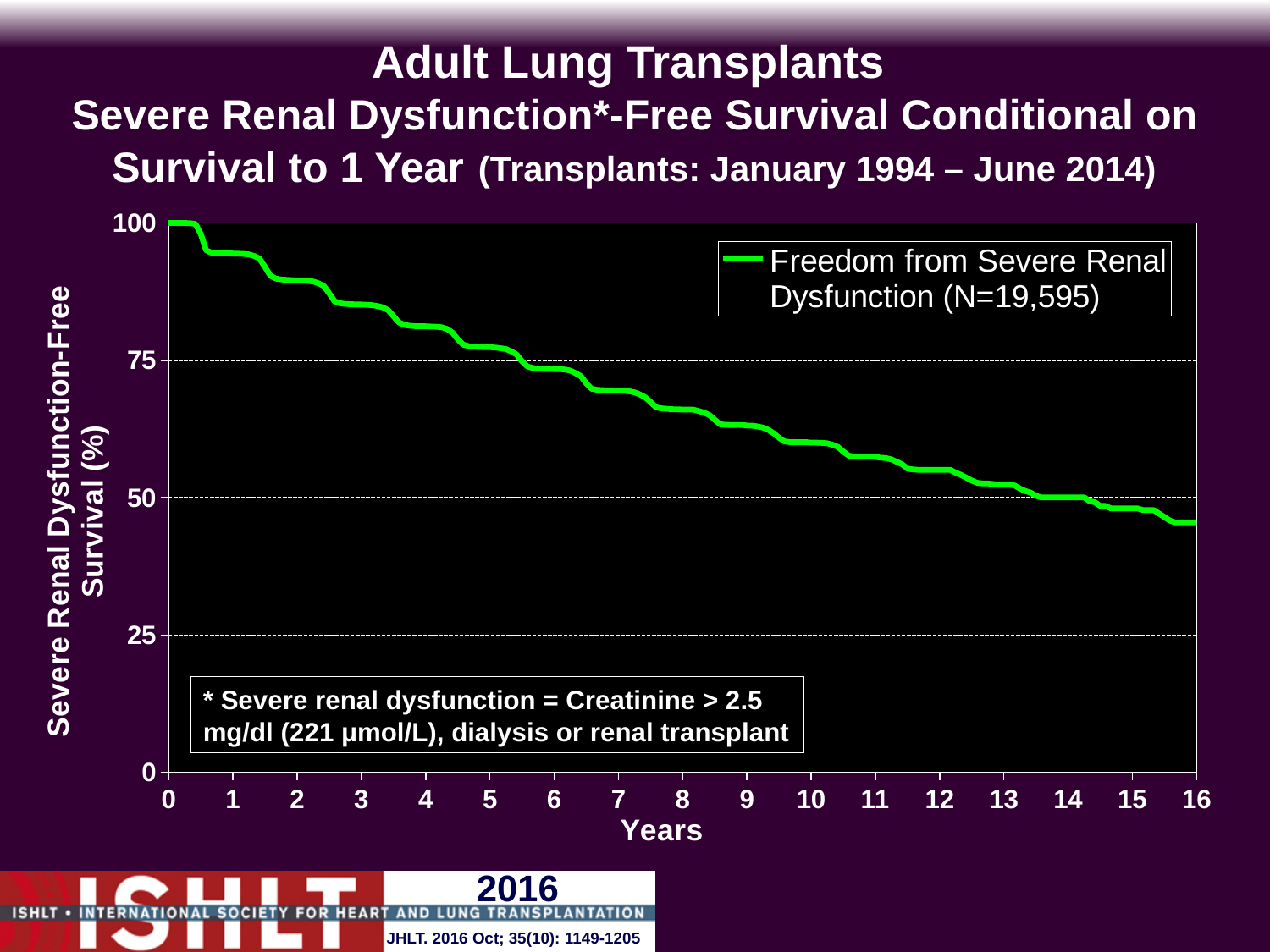
Is the value of the curve at year 8 greater or less than 75? less Is the value of the curve at year 10 greater or less than 50? greater Is the value of the curve at year 2 greater or less than 75? greater Does the Freedom from Severe Renal Dysfunction curve rise or fall as years increase? fall What is the N given in the legend for the Freedom from Severe Renal Dysfunction series? 19,595 How many series does the legend list? 1 What is the value of the Freedom from Severe Renal Dysfunction curve at year 0? 100 What kind of chart is shown on the slide? line chart What is the label of the x axis? Years